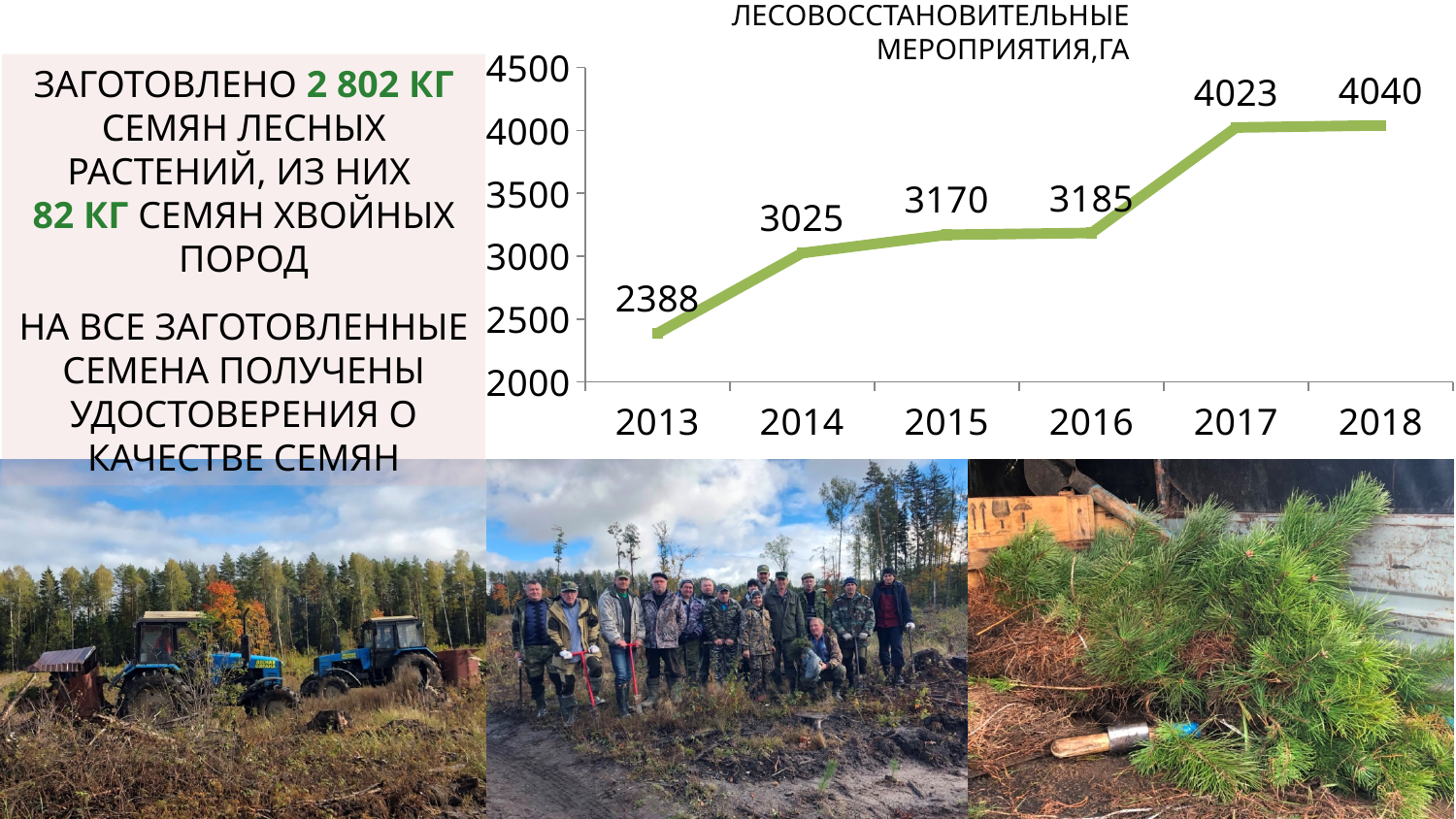
Which year has the lowest value in the chart? 2013 Is the value for 2017 greater or less than 3500? greater Do the values rise or fall from 2013 to 2018? rise What is the value for 2013 in the chart? 2388 Which is larger, the value for 2015 or the value for 2014? 2015 What is the value for 2018 in the chart? 4040 Which year has the highest value in the chart? 2018 How many years are plotted in the chart? 6 What is the difference between the values for 2017 and 2016? 838 What is the value for 2016 in the chart? 3185 What kind of chart is shown on the slide? line chart What is the difference between the values for 2014 and 2013? 637